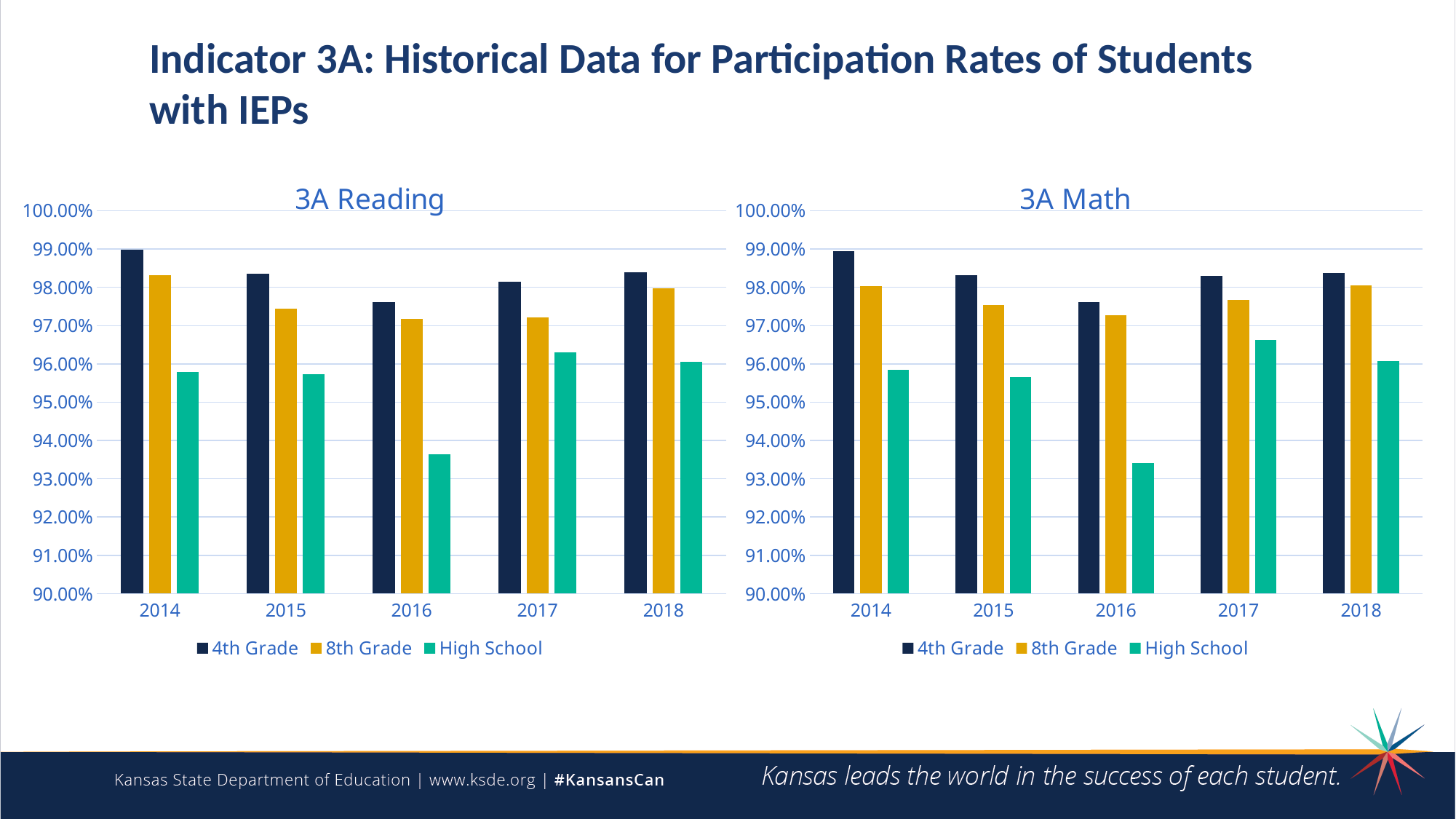
In the 3A Reading chart, which series is shown in green? High School In the 3A Math chart, which year has the lowest High School participation rate? 2016 In the 3A Math chart, how many series does the legend list? 3 In the 3A Reading chart, which year has the highest 4th Grade participation rate? 2014 In the 3A Math chart, is the 8th Grade value for 2016 greater or less than 98.00%? less In the 3A Math chart, is the 4th Grade value for 2014 greater or less than 98.00%? greater In the 3A Reading chart, is the High School value for 2016 greater or less than 94.00%? less In the 3A Math chart, which year has the highest 4th Grade participation rate? 2014 What type of chart is the 3A Reading chart? bar chart In the 3A Reading chart, how many years are shown on the x axis? 5 In the 3A Reading chart, which year has the lowest High School participation rate? 2016 In the 3A Reading chart, which is larger for 2014: 4th Grade or High School? 4th Grade